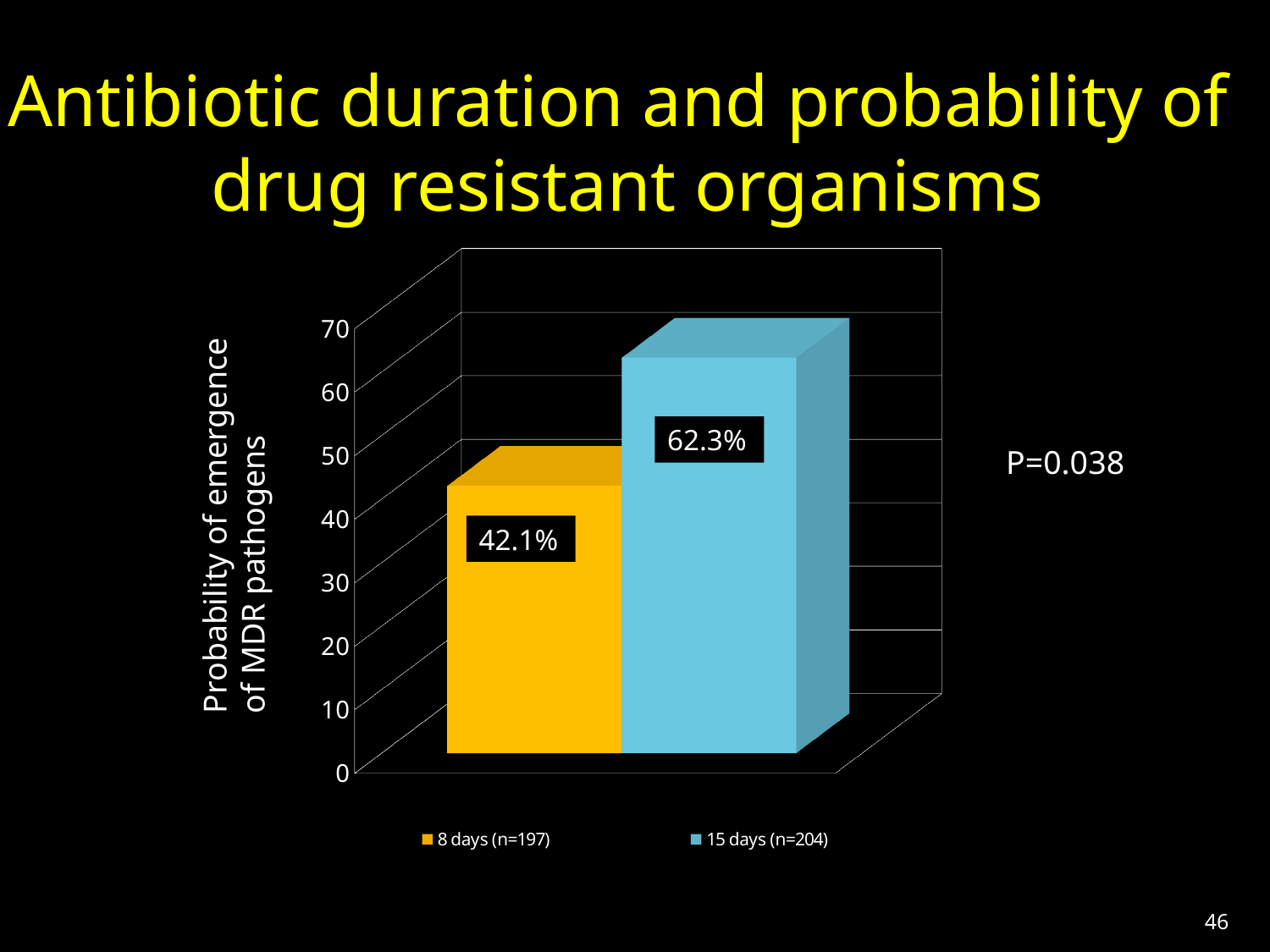
Is the value for the 15 days group greater or less than 60? greater What kind of chart is shown on the slide? bar chart What P value is shown next to the chart? P=0.038 Which group has the lower probability of emergence of MDR pathogens? 8 days (n=197) Is the value for the 8 days group greater or less than 50? less What is the title of the slide containing the chart? Antibiotic duration and probability of drug resistant organisms Which group has the higher probability of emergence of MDR pathogens? 15 days (n=204) What is the probability of emergence of MDR pathogens for the 15 days (n=204) group? 62.3% What is the difference in probability of emergence of MDR pathogens between the 15 days and 8 days groups? 20.2% What is the label of the vertical axis? Probability of emergence of MDR pathogens How many series does the legend list? 2 What is the probability of emergence of MDR pathogens for the 8 days (n=197) group? 42.1%